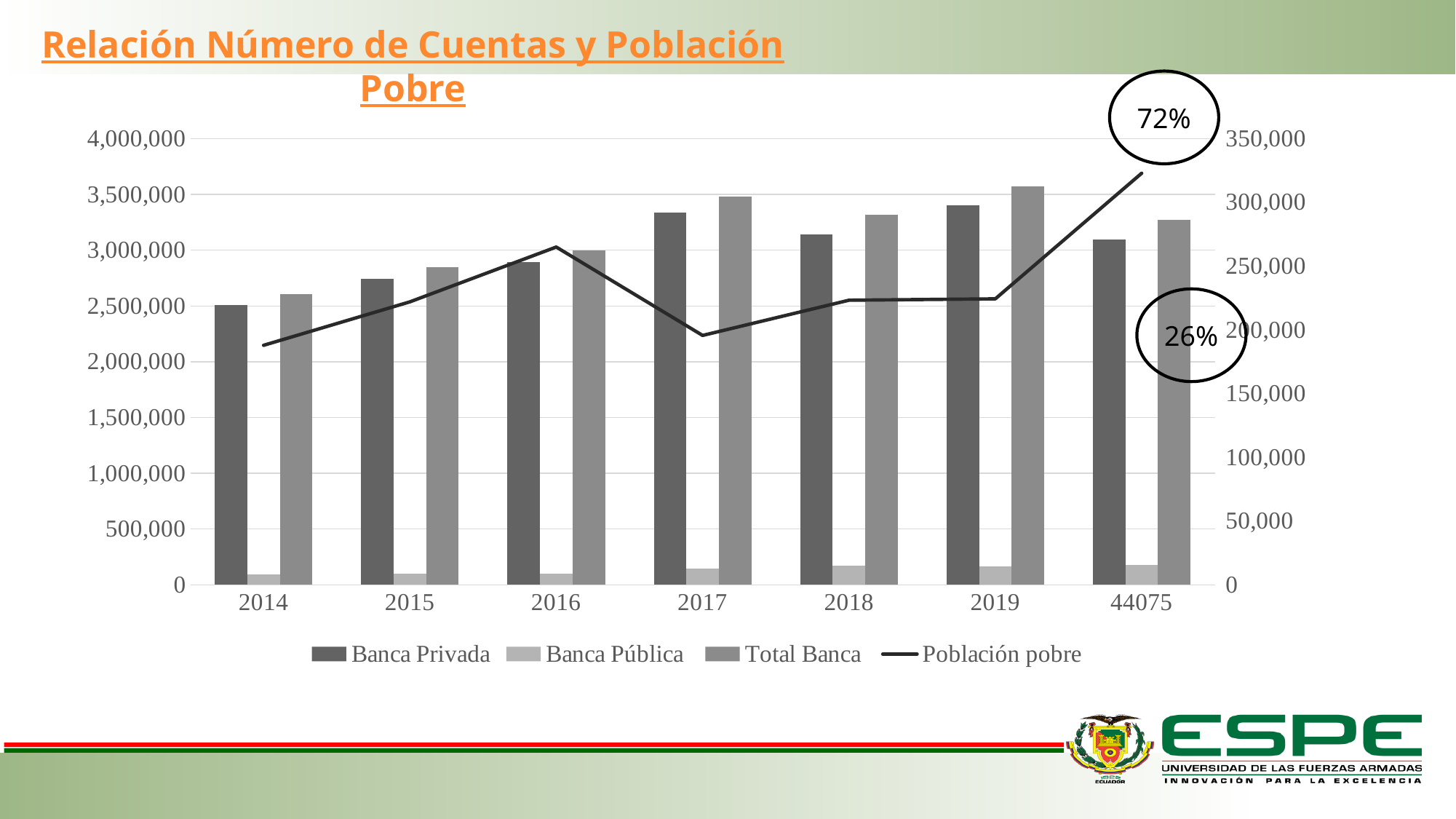
In which year is the Total Banca bar the highest? 2019 Is the Banca Privada value for 2014 greater or less than 2,000,000? greater Which series is drawn as a line rather than bars? Población pobre Does the Población pobre line rise or fall between 2019 and 44075? rise How many categories are shown along the x axis? 7 In which year is the Banca Privada bar the lowest? 2014 How many series does the legend list? 4 Is the Banca Pública value for 2018 greater or less than 500,000? less At which x-axis category does the Población pobre line reach its highest point? 44075 Which is larger, the Banca Privada bar for 2017 or for 2018? 2017 What kind of chart is shown on the slide? A combined bar and line chart In which year is the Total Banca bar the lowest? 2014